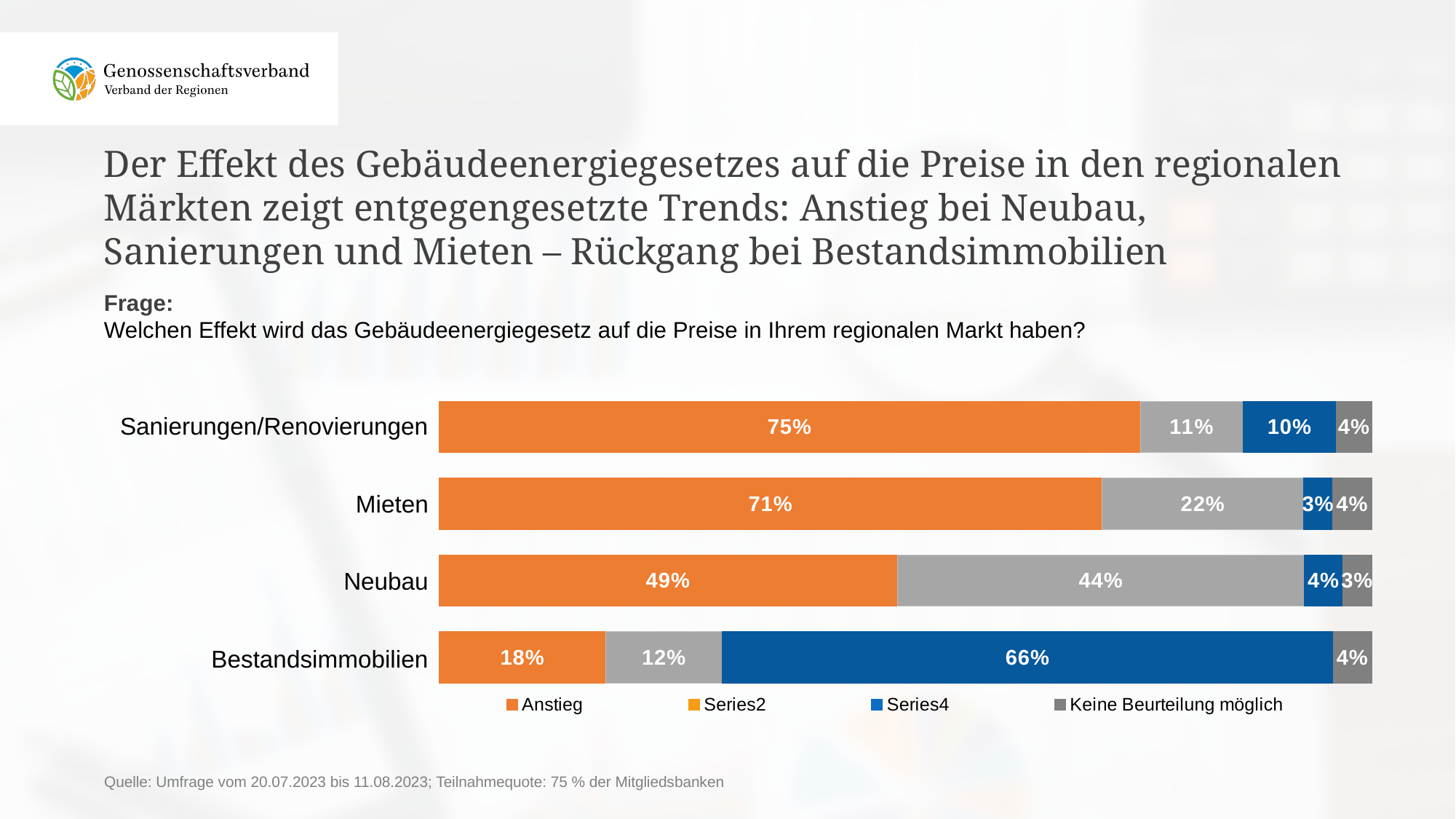
What is the Keine Beurteilung möglich value for Neubau? 3% Which category has the highest Anstieg value? Sanierungen/Renovierungen Which has the larger Anstieg value, Mieten or Neubau? Mieten What is the Anstieg value for Bestandsimmobilien? 18% What is the Series4 value for Bestandsimmobilien? 66% Which category has the lowest Anstieg value? Bestandsimmobilien What is the Anstieg value for Sanierungen/Renovierungen? 75% How many series does the legend list? 4 How many categories are shown in the chart? 4 What is the difference between the Anstieg values for Sanierungen/Renovierungen and Mieten? 4 percentage points What is the Anstieg value for Neubau? 49% What kind of chart is shown on the slide? Stacked bar chart